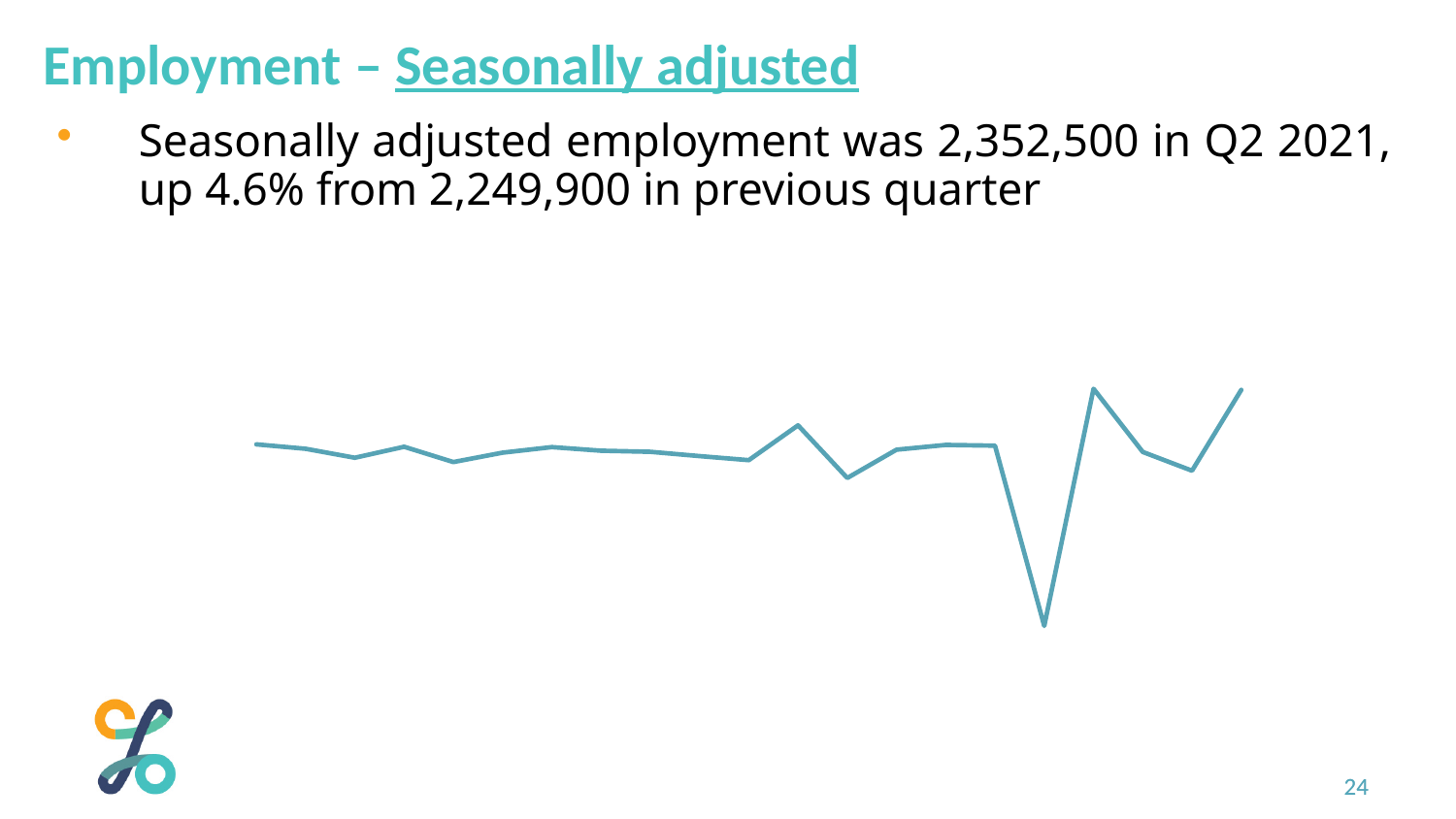
How many lines are plotted on the chart? 1 What colour is the line on the chart? teal Is the sharpest drop in the line located in the left half or the right half of the chart? right half Does the line end higher or lower than where it starts? higher What kind of chart is shown on the slide? line chart